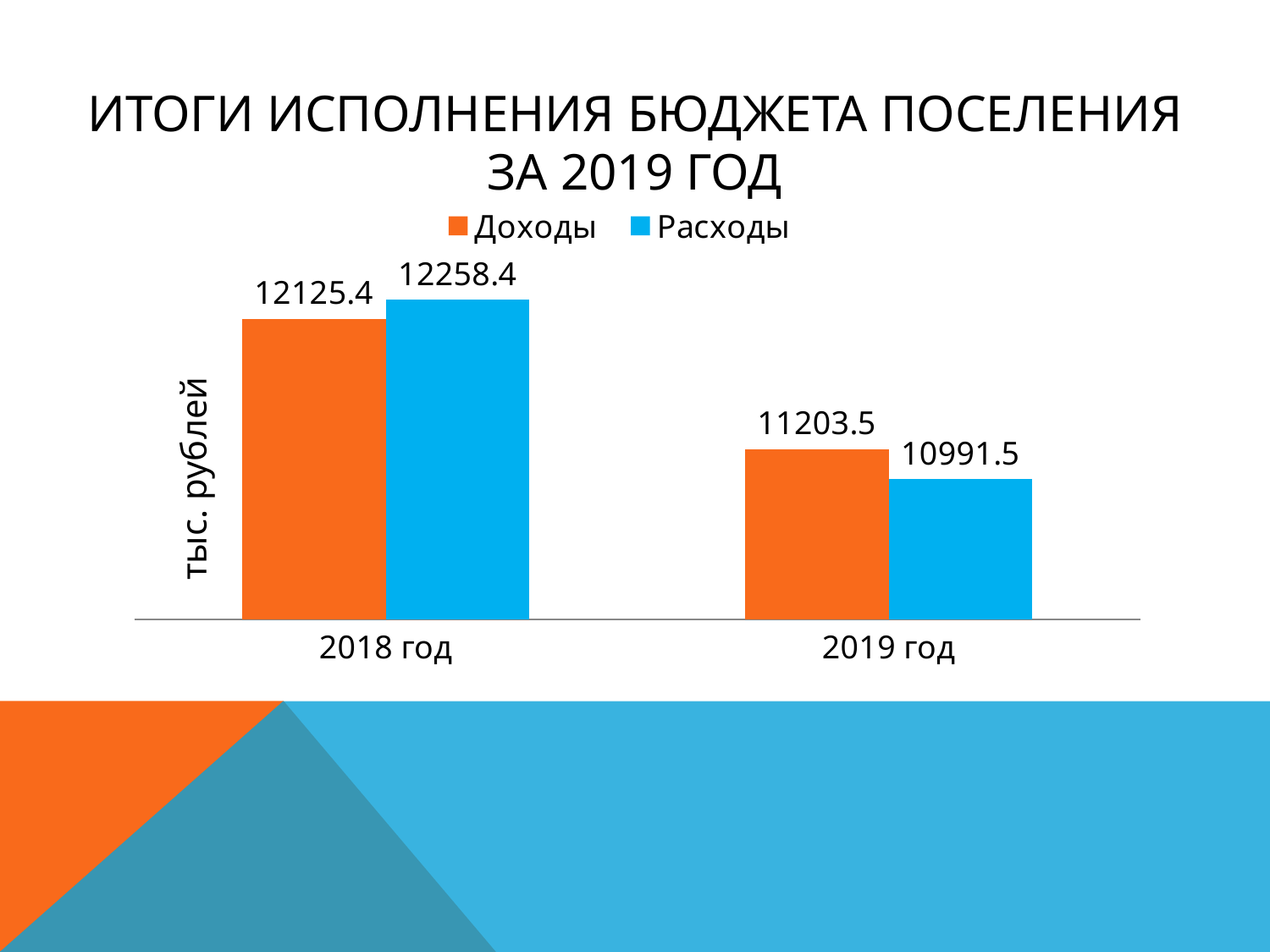
Which year has the higher value for Расходы? 2018 год What is the value of Доходы for 2018 год? 12125.4 What is the label on the vertical axis? тыс. рублей What is the value of Расходы for 2018 год? 12258.4 How many series does the legend list? 2 What kind of chart is shown on the slide? Bar chart What is the difference between Доходы and Расходы for 2019 год? 212.0 What is the value of Расходы for 2019 год? 10991.5 For 2019 год, which is larger: Доходы or Расходы? Доходы What is the value of Доходы for 2019 год? 11203.5 What is the difference between Расходы and Доходы for 2018 год? 133.0 Which year has the lower value for Доходы? 2019 год